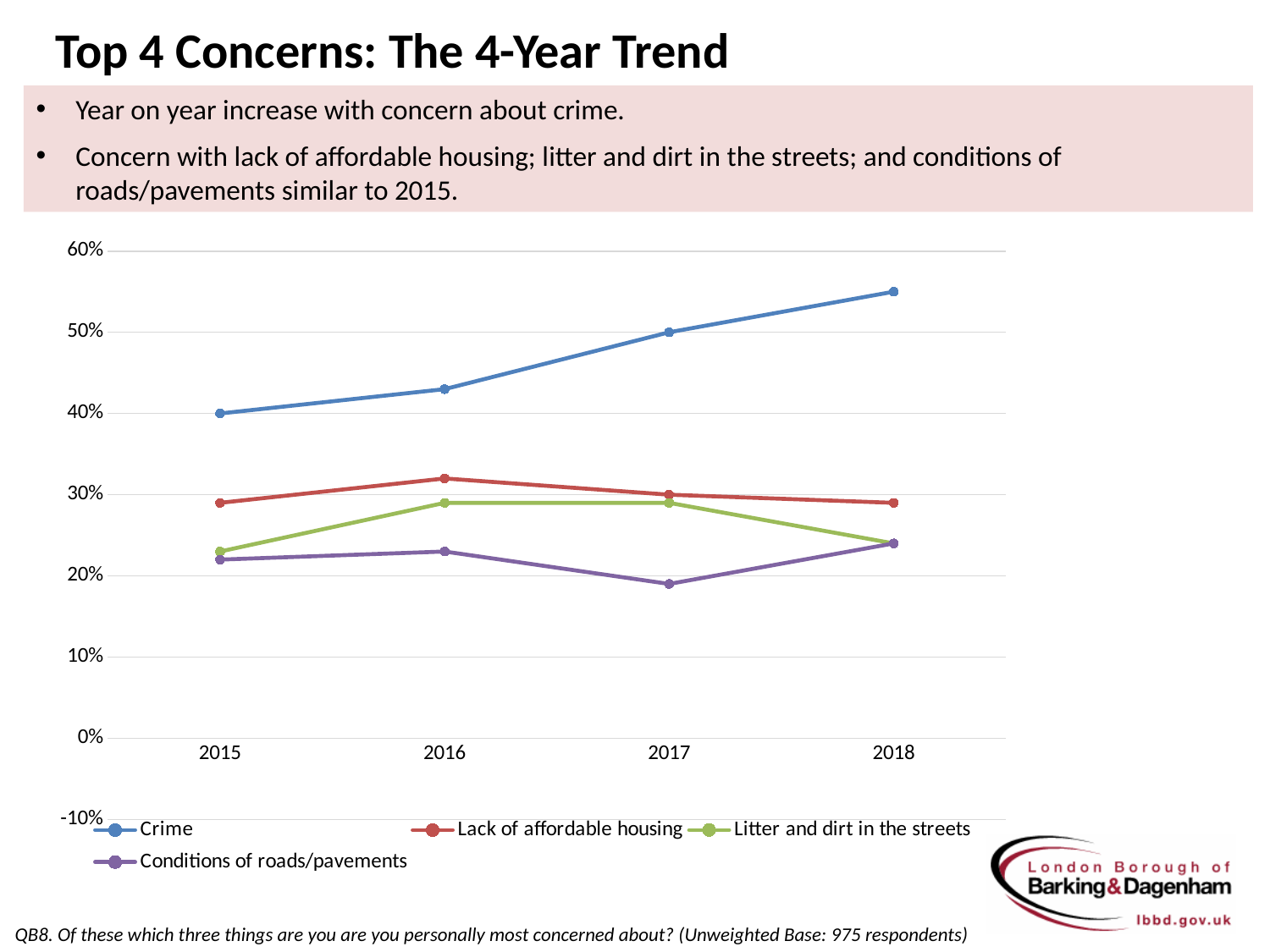
What is the value for Lack of affordable housing in 2017? 30% Is the value for Conditions of roads/pavements in 2017 greater or less than 20%? less Does the value for Crime rise or fall from 2015 to 2018? rise What is the value for Crime in 2017? 50% What kind of chart is shown on the slide? line chart How many series does the legend list? 4 Is the value for Crime in 2018 greater or less than 50%? greater Which series has the lowest value in 2017? Conditions of roads/pavements What is the value for Crime in 2015? 40% How many years are plotted along the x axis? 4 Is the value for Lack of affordable housing in 2016 greater or less than 30%? greater Which series has the highest value in 2018? Crime